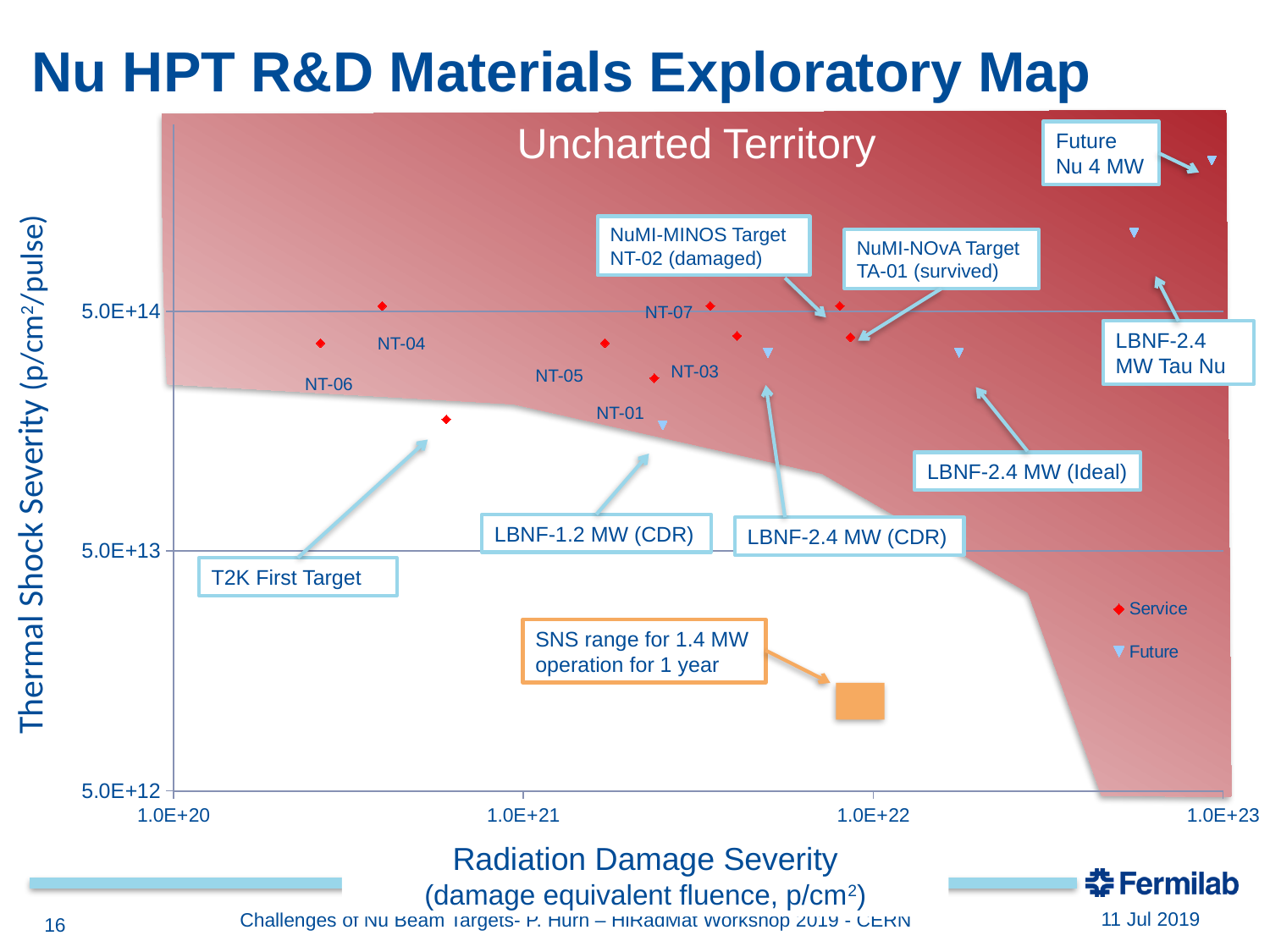
How many series does the chart legend list? 2 What kind of chart is shown on the slide? scatter chart What are the two series named in the chart legend? Service and Future Which has the higher thermal shock severity, LBNF-2.4 MW Tau Nu or LBNF-1.2 MW (CDR)? LBNF-2.4 MW Tau Nu Is the thermal shock severity for LBNF-2.4 MW Tau Nu greater or less than 5.0E+14? greater Is the radiation damage severity for LBNF-2.4 MW (CDR) greater or less than 1.0E+22? less Is the radiation damage severity for LBNF-2.4 MW (Ideal) greater or less than 1.0E+22? greater Which labeled point has the highest thermal shock severity? Future Nu 4 MW What quantity is plotted on the vertical axis of the chart? Thermal Shock Severity (p/cm²/pulse)